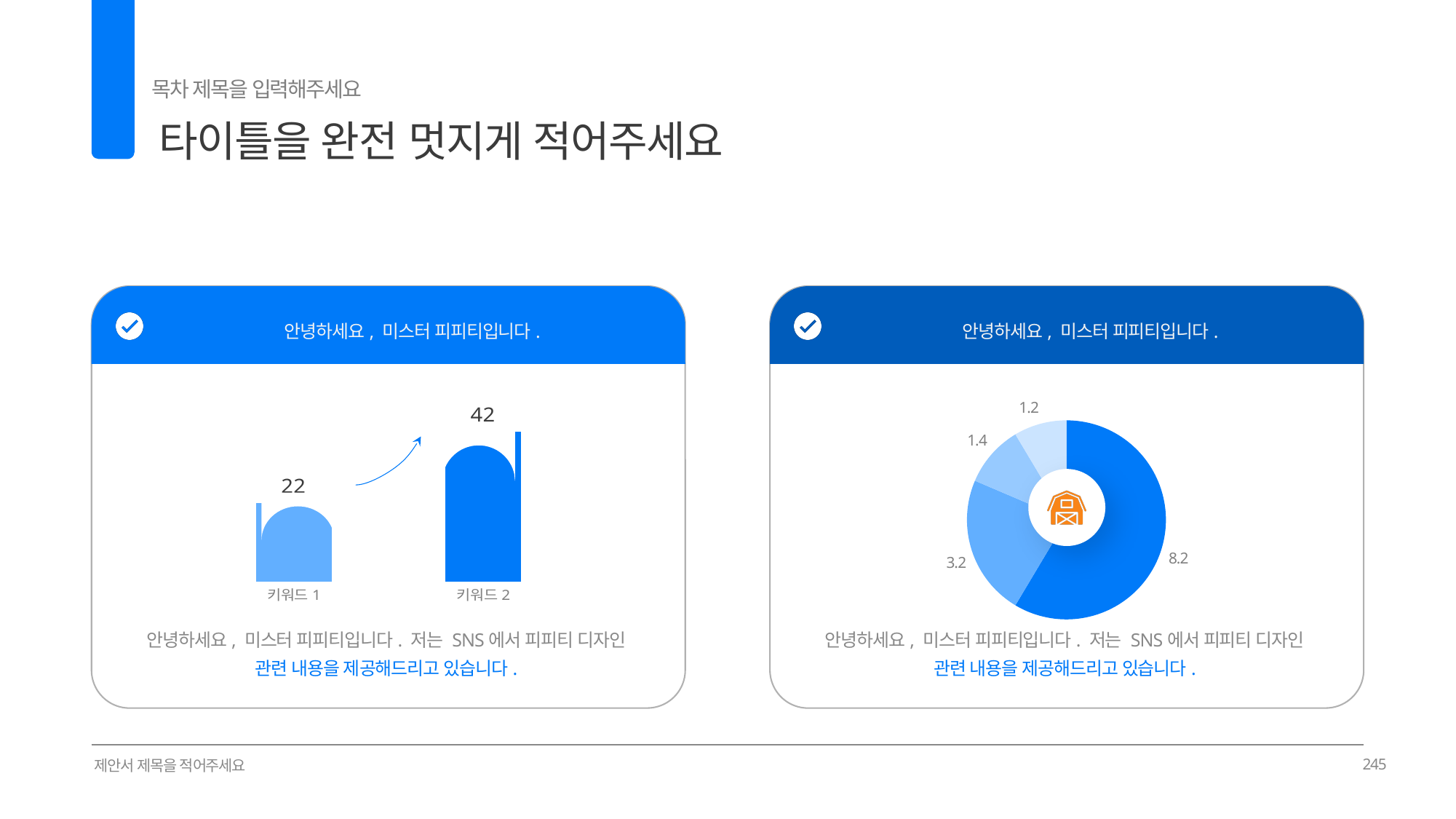
In the right chart, what is the value of the largest slice? 8.2 In the left chart, is the value for 키워드 1 larger or smaller than the value for 키워드 2? smaller What kind of chart is shown in the right card? doughnut chart How many slices does the doughnut chart in the right card have? 4 How many categories does the left chart show? 2 What kind of chart is shown in the left card? bar chart In the left chart, do the values rise or fall from 키워드 1 to 키워드 2? rise In the left chart, what is the value for 키워드 2? 42 In the left chart, what is the value for 키워드 1? 22 In the left chart, which category has the lower value? 키워드 1 In the left chart, what is the difference between the values for 키워드 2 and 키워드 1? 20 In the left chart, which category has the higher value? 키워드 2